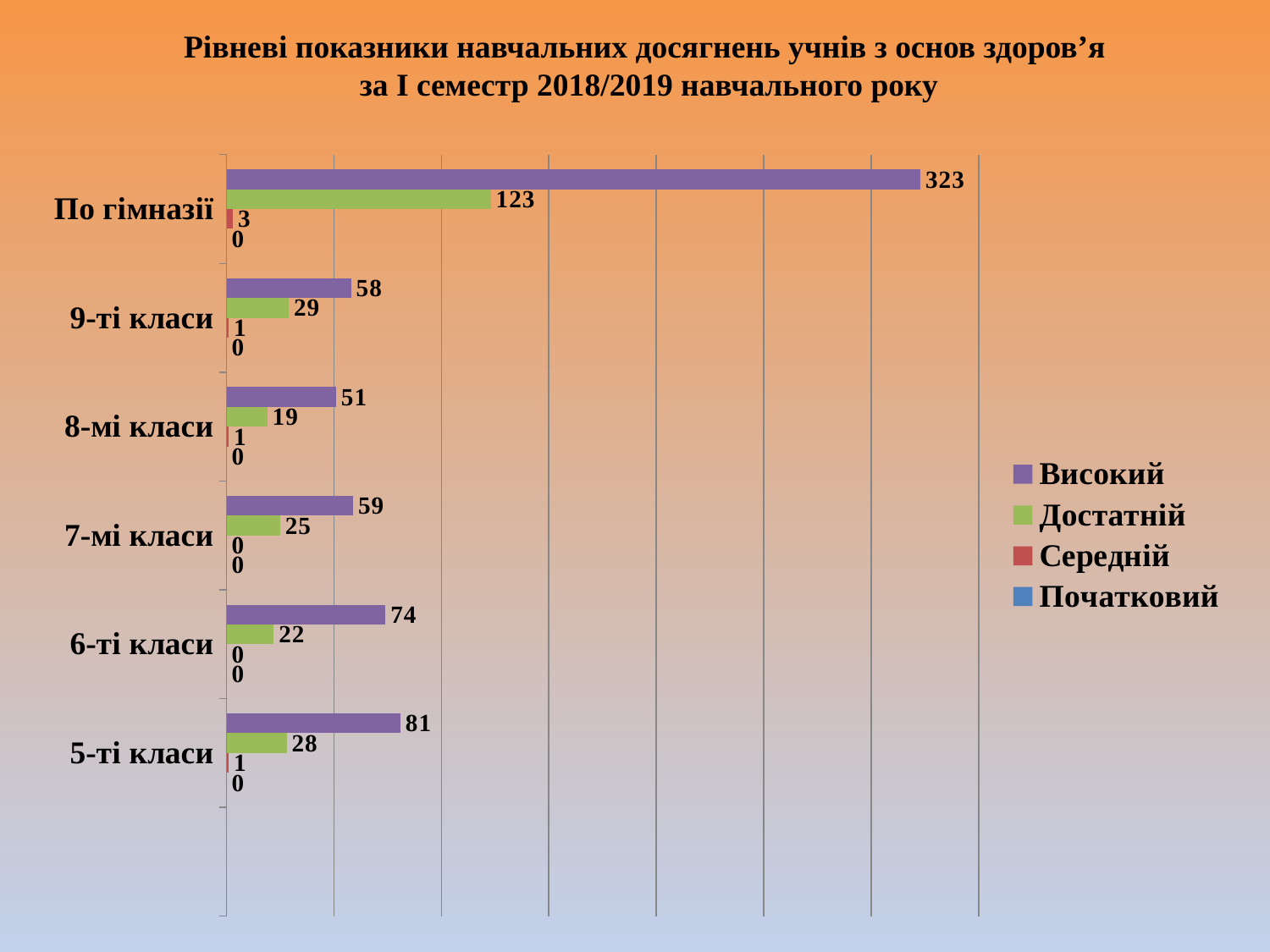
What is the value of Середній for По гімназії? 3 What is the value of Достатній for 9-ті класи? 29 What is the difference between the Високий values for 5-ті класи and 8-мі класи? 30 Among the class groups (excluding По гімназії), which has the lowest Достатній value? 8-мі класи How many categories are shown on the chart? 6 What is the value of Високий for 6-ті класи? 74 Which is larger, the Достатній value for 7-мі класи or for 6-ті класи? 7-мі класи Among the class groups (excluding По гімназії), which has the highest Високий value? 5-ті класи How many series does the legend list? 4 What kind of chart is shown on the slide? Bar chart What is the value of Високий for По гімназії? 323 Which legend entry is shown in purple? Високий